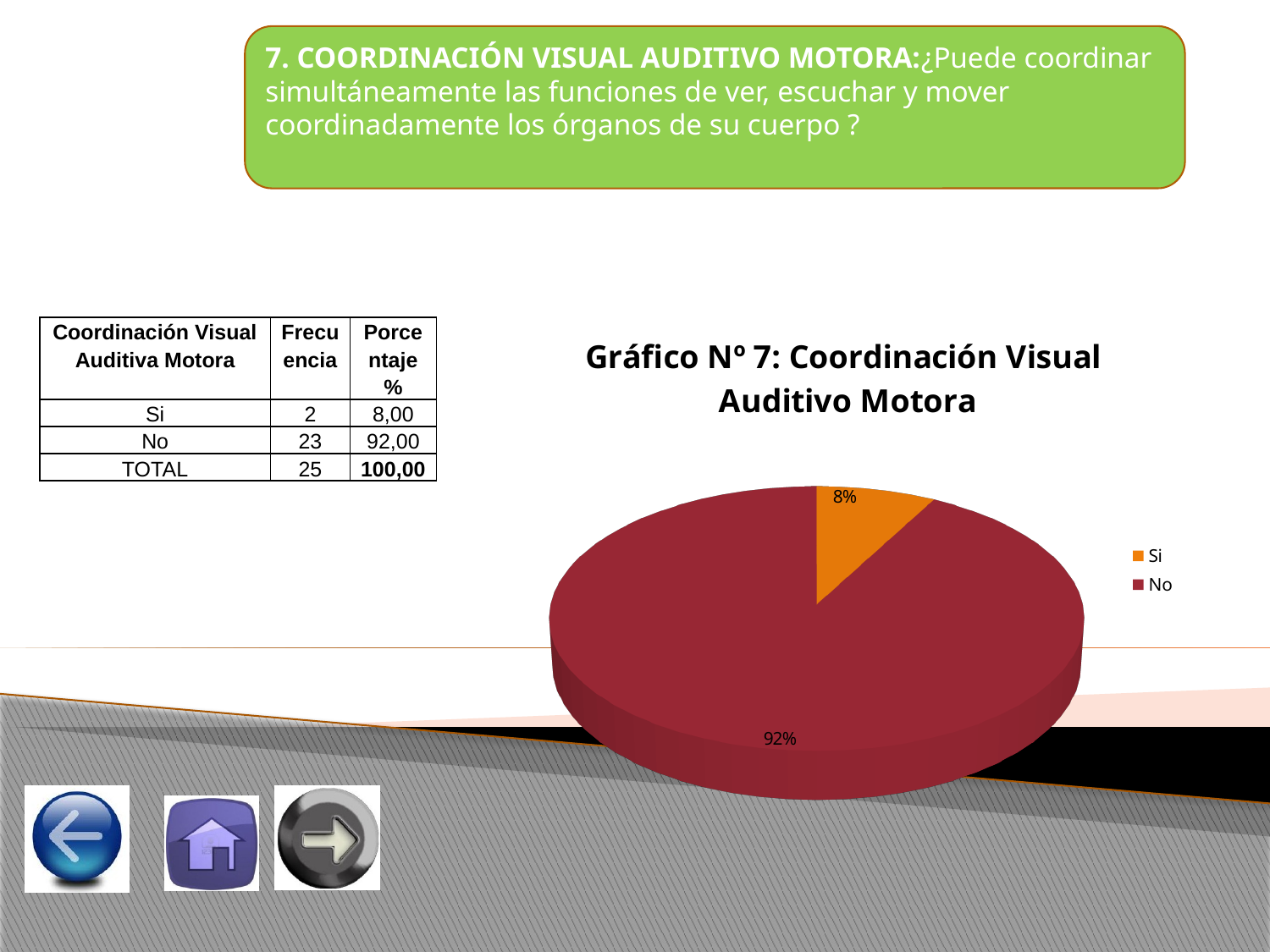
What is the difference in percentage points between the 'No' slice and the 'Si' slice? 84 What colour is the 'No' slice in the pie chart? Dark red How many slices does the pie chart have? 2 How many entries does the legend list? 2 Which category has the largest slice in the pie chart? No What share of the pie does the 'Si' slice represent? 8% Which slice is larger, 'Si' or 'No'? No What kind of chart is shown on the slide? Pie chart What is the title of the chart? Gráfico Nº 7: Coordinación Visual Auditivo Motora What percentage does the 'No' slice show in the pie chart? 92% What percentage does the 'Si' slice show in the pie chart? 8% Which category has the smallest slice in the pie chart? Si